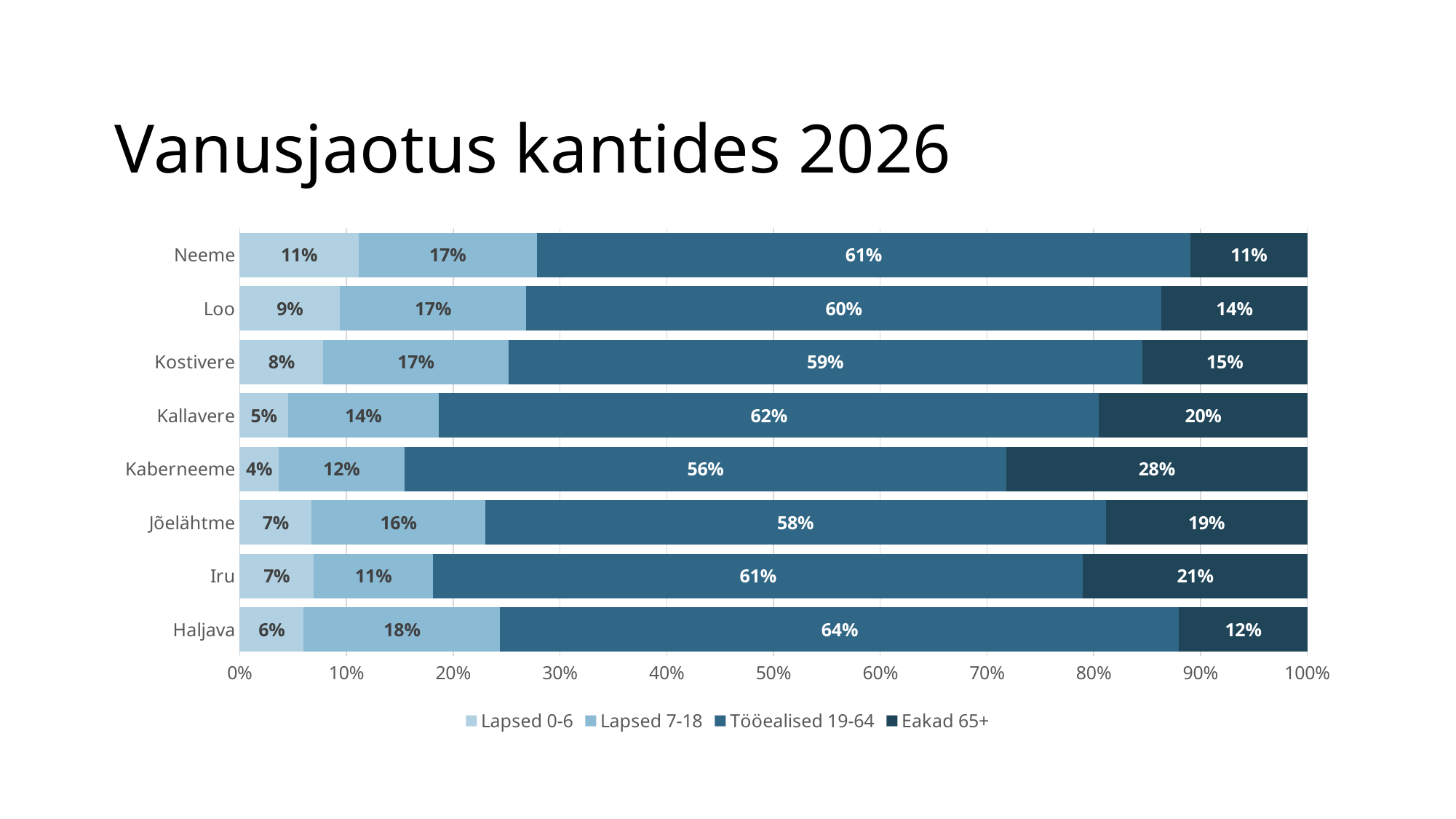
What is the title of the chart? Vanusjaotus kantides 2026 What is the value for Lapsed 0-6 in Neeme? 11% Which is larger: Tööealised 19-64 in Kallavere or in Jõelähtme? Kallavere How many series does the legend list? 4 What is the value for Tööealised 19-64 in Haljava? 64% What kind of chart is shown on the slide? Stacked bar chart What is the difference between the Eakad 65+ values for Iru and Haljava? 9% How many categories are shown on the chart? 8 What is the value for Lapsed 7-18 in Iru? 11% Which category has the lowest value for Lapsed 0-6? Kaberneeme What is the value for Eakad 65+ in Kaberneeme? 28% Which category has the highest value for Eakad 65+? Kaberneeme